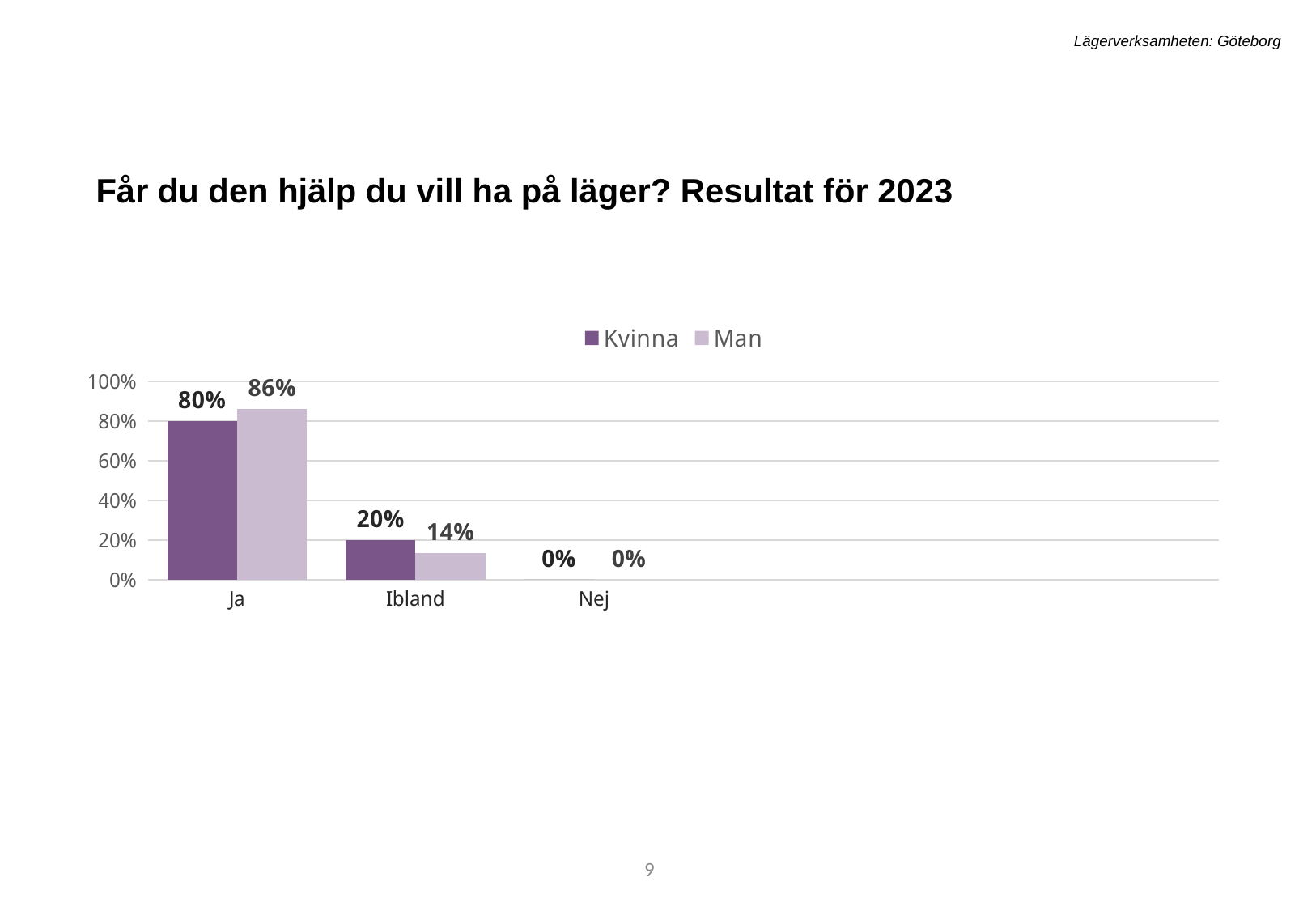
What is the difference between the Man and Kvinna values in the Ja category? 6% Which category has the lowest value for the Kvinna series? Nej How many categories are shown on the x axis? 3 What is the value for Kvinna in the Ibland category? 20% In the Ibland category, which series has the larger value, Kvinna or Man? Kvinna What kind of chart is shown on the slide? Bar chart What is the value for Kvinna in the Nej category? 0% What is the value for Kvinna in the Ja category? 80% What is the value for Man in the Ja category? 86% Which category has the highest value for the Man series? Ja How many series does the legend list? 2 What is the value for Man in the Ibland category? 14%